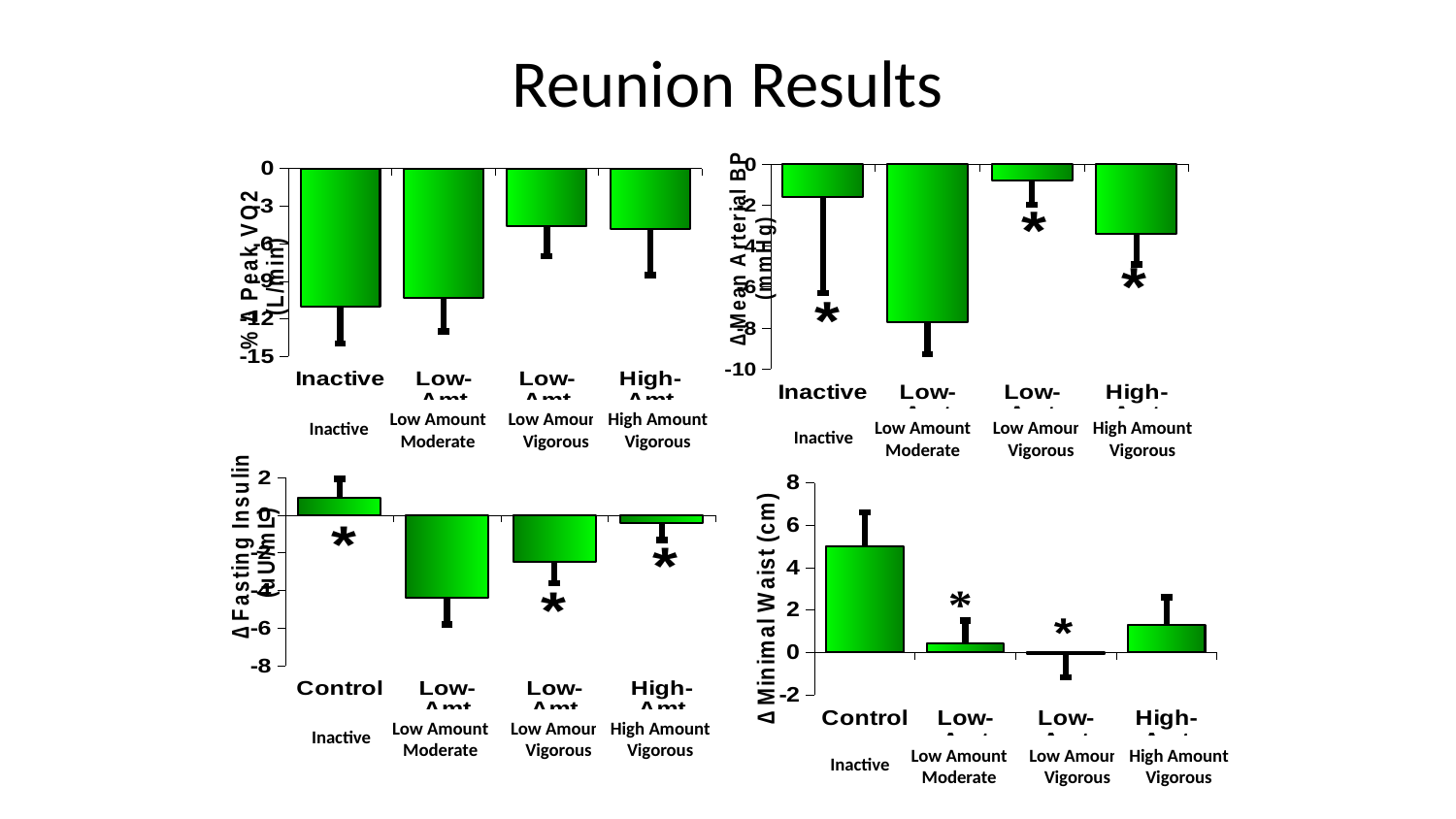
In the Δ Mean Arterial BP (mmHg) chart at the top right, which category has the lowest (most negative) value? Low Amount Moderate In the Δ Fasting Insulin chart at the bottom left, which category has the lowest (most negative) value? Low Amount Moderate In the Δ Minimal Waist (cm) chart at the bottom right, which is larger, the value for Control or the value for High Amount Vigorous? Control How many categories are plotted in the Δ Peak VO2 chart at the top left of the slide? 4 In the Δ Minimal Waist (cm) chart at the bottom right, is the value for High Amount Vigorous greater or less than 2? less What kind of chart is the Δ Minimal Waist (cm) chart at the bottom right of the slide? bar chart In the Δ Peak VO2 chart at the top left, is the value for Inactive greater or less than -9? less In the Δ Minimal Waist (cm) chart at the bottom right, is the value for Control greater or less than 4? greater In the Δ Minimal Waist (cm) chart at the bottom right, which category has the highest value? Control (Inactive) What is the title of the slide containing the four charts? Reunion Results